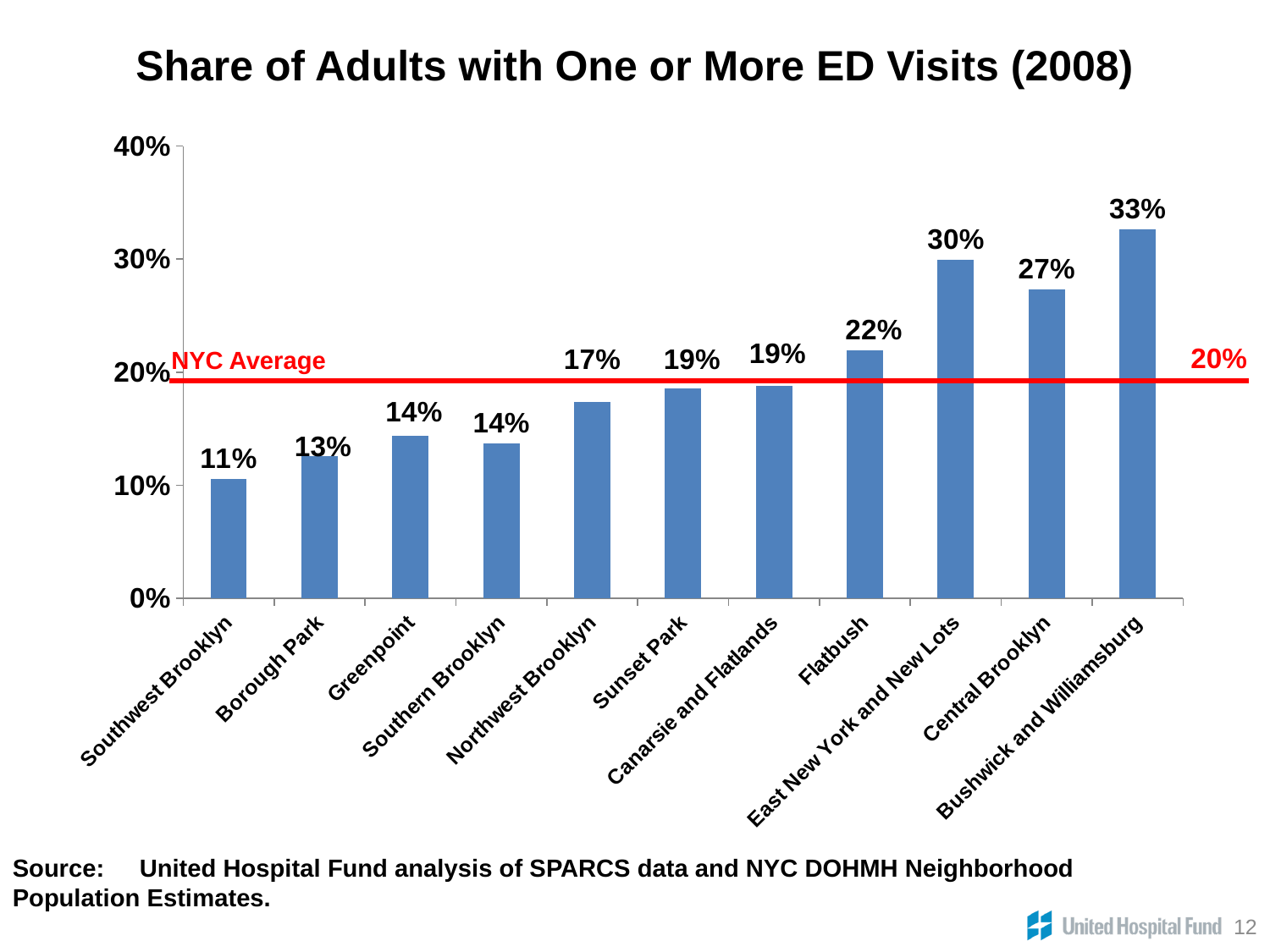
What is the difference between the values for Bushwick and Williamsburg and Southwest Brooklyn? 22 percentage points What is the share of adults with one or more ED visits in Flatbush? 22% Which neighborhood has the lowest share of adults with one or more ED visits? Southwest Brooklyn What value is shown for the NYC Average line on the chart? 20% What is the value shown for Bushwick and Williamsburg? 33% Do the values generally rise or fall from left to right across the neighborhoods? Rise Which has a larger value, Central Brooklyn or Northwest Brooklyn? Central Brooklyn How many neighborhoods are shown on the chart? 11 Which neighborhood has the highest share of adults with one or more ED visits? Bushwick and Williamsburg What is the value shown for East New York and New Lots? 30% What is the value shown for Southwest Brooklyn? 11% What kind of chart is shown on the slide? Bar chart